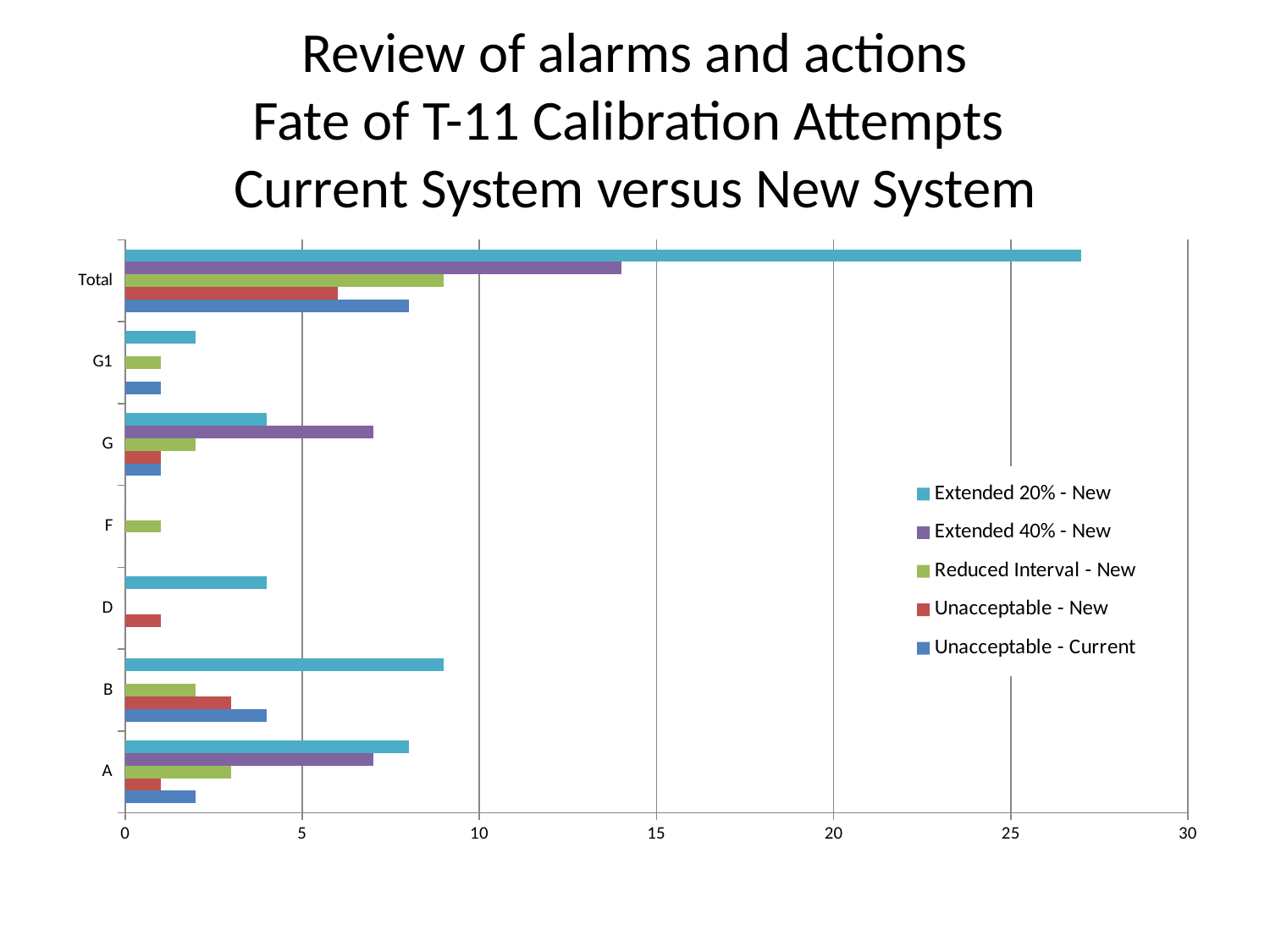
Is the value for Extended 40% - New in category G greater or less than 5? greater Is the value for Reduced Interval - New in the Total category greater or less than 10? less How many categories are shown on the vertical axis? 7 How many series does the legend list? 5 Which series has the highest value in the Total category? Extended 20% - New What kind of chart is shown on the slide? Bar chart Is the value for Extended 40% - New in the Total category greater or less than 10? greater What is the maximum value shown on the horizontal axis? 30 Which series has the lowest value in the Total category? Unacceptable - New In category G, which is larger: Extended 20% - New or Extended 40% - New? Extended 40% - New